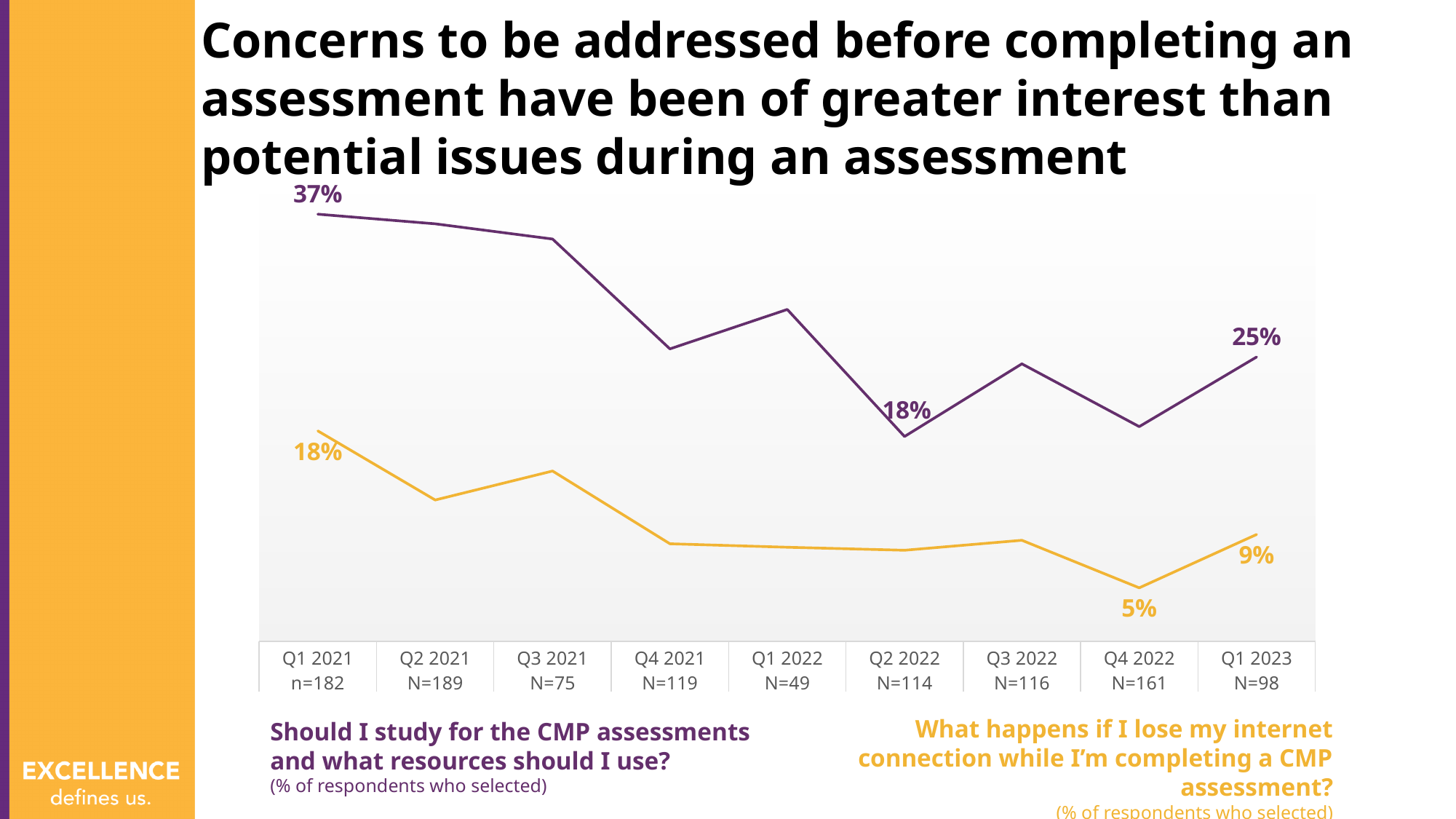
What percentage of respondents selected 'What happens if I lose my internet connection while I'm completing a CMP assessment?' in Q1 2021? 18% In Q1 2023, which series has the higher value: 'Should I study for the CMP assessments' or 'lose my internet connection'? Should I study for the CMP assessments What value is labelled for the 'Should I study for the CMP assessments' series in Q1 2023? 25% What is the sample size (N) shown for Q1 2022? N=49 What kind of chart is shown on the slide? line chart What value is labelled for the 'Should I study for the CMP assessments' series in Q2 2022? 18% How many quarters are shown along the x axis of the chart? 9 What is the difference between the 'Should I study' value in Q1 2021 and its value in Q1 2023? 12% What value is labelled for the 'lose my internet connection' series in Q1 2023? 9% What value is labelled for the 'lose my internet connection' series in Q4 2022? 5% How many series are plotted on the chart? 2 What percentage of respondents selected 'Should I study for the CMP assessments and what resources should I use?' in Q1 2021? 37%